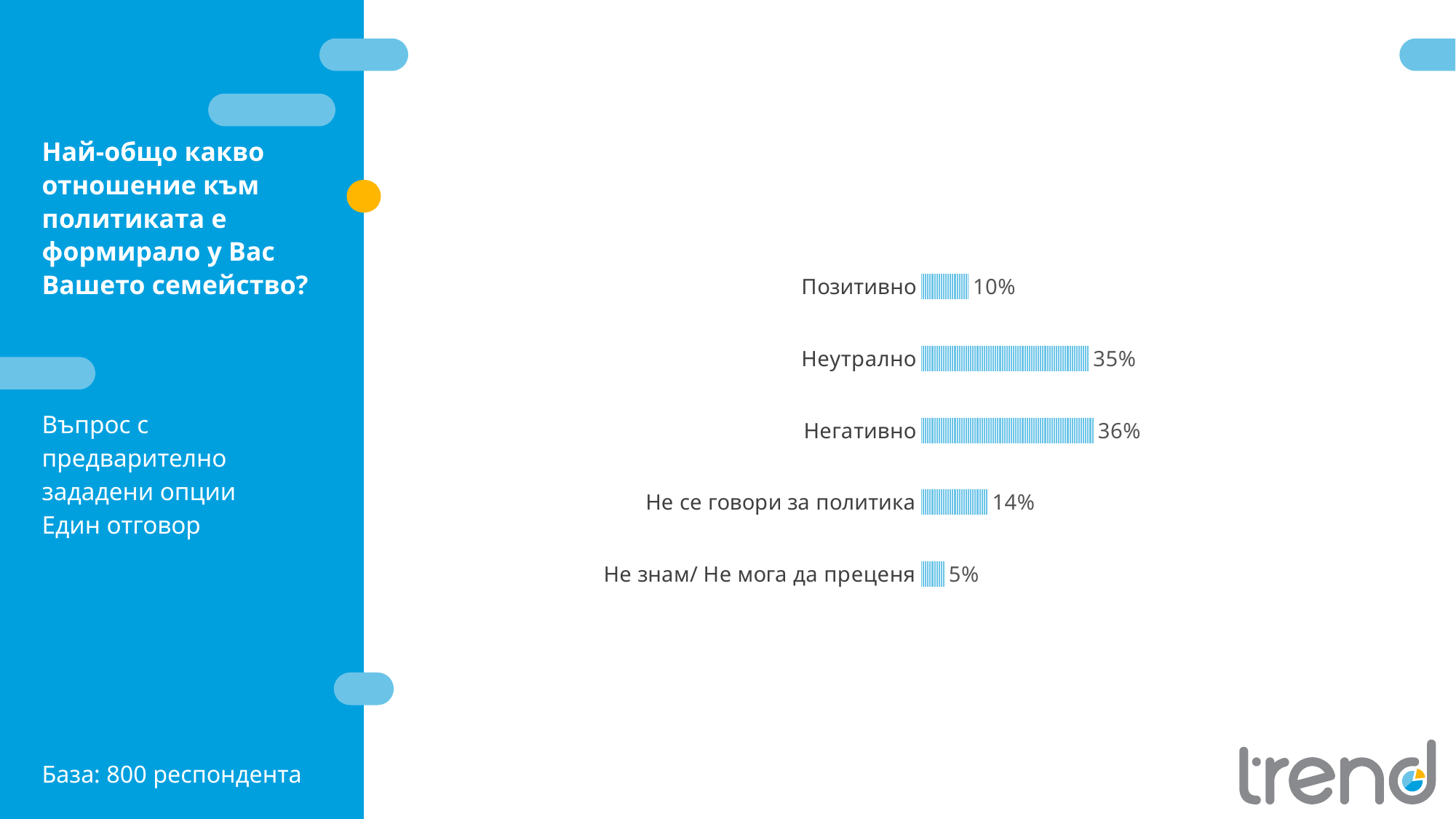
What is the base (number of respondents) stated on the slide? 800 респондента What is the value for Не се говори за политика? 14% What is the value for Не знам/ Не мога да преценя? 5% Which category has the highest value? Негативно What kind of chart is shown on the slide? Bar chart What is the difference between the values for Неутрално and Позитивно? 25% Which category has the lowest value? Не знам/ Не мога да преценя What is the value for Негативно? 36% How many categories are shown in the chart? 5 What is the value for Неутрално? 35% Which is larger, the value for Не се говори за политика or the value for Позитивно? Не се говори за политика What is the value for Позитивно? 10%